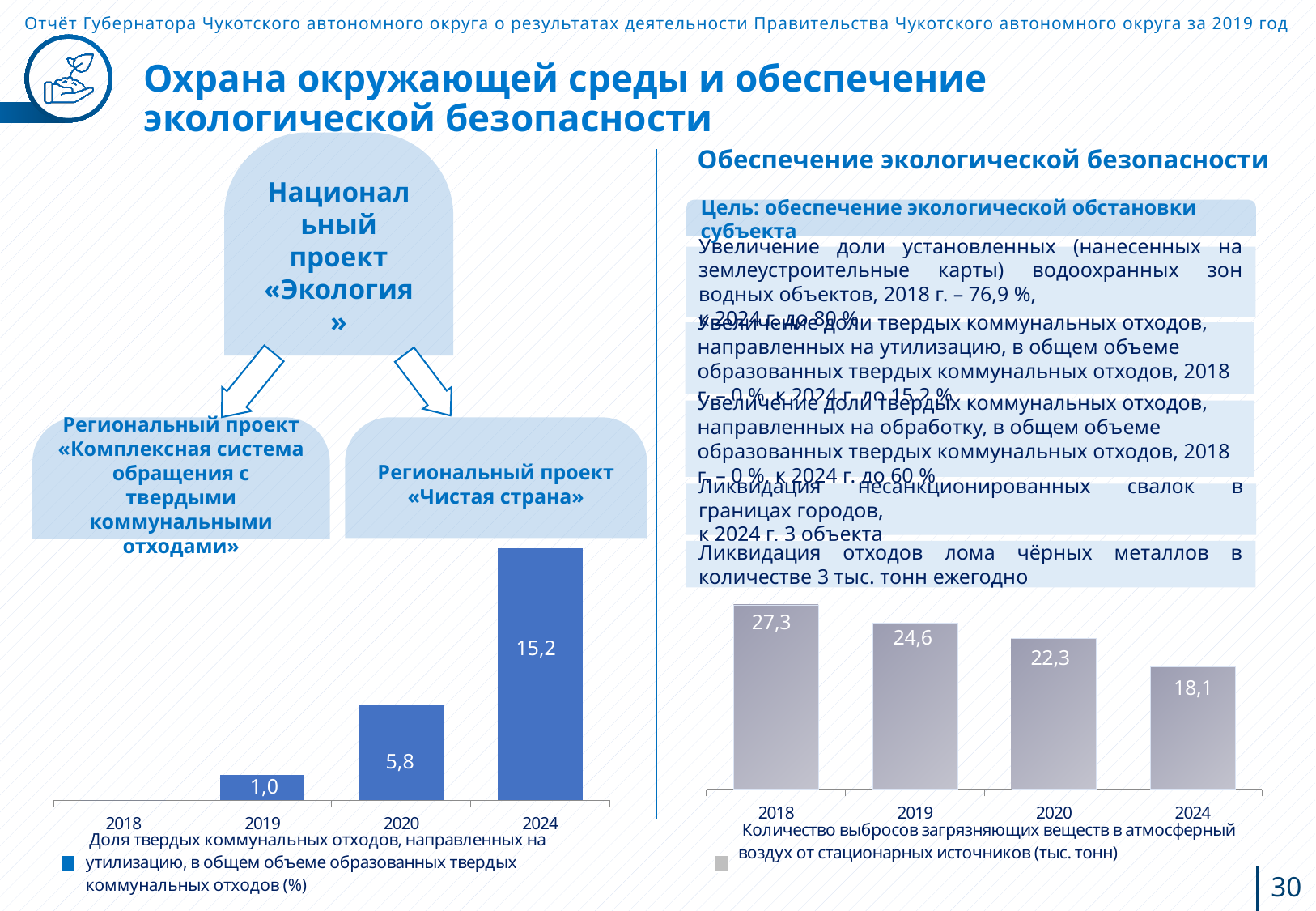
In the right chart (emissions of pollutants into the air from stationary sources), which year has the lowest value? 2024 In the left chart (share of municipal solid waste sent for recycling), which year has the highest value? 2024 In the left chart (share of municipal solid waste sent for recycling), do the values rise or fall from 2019 to 2024? rise In the right chart (emissions of pollutants into the air from stationary sources), what is the value for 2024? 18,1 What type of chart is the right chart (emissions of pollutants into the air from stationary sources)? bar chart In the left chart (share of municipal solid waste sent for recycling), what is the value for 2024? 15,2 In the right chart (emissions of pollutants into the air from stationary sources), what is the value for 2018? 27,3 In the left chart (share of municipal solid waste sent for recycling), what is the difference between the 2024 and 2020 values? 9,4 In the left chart (share of municipal solid waste sent for recycling), what is the value for 2019? 1,0 In the left chart (share of municipal solid waste sent for recycling), what is the value for 2020? 5,8 In the right chart (emissions of pollutants into the air from stationary sources), do the values rise or fall from 2018 to 2024? fall In the right chart (emissions of pollutants into the air from stationary sources), what is the difference between the 2019 and 2020 values? 2,3